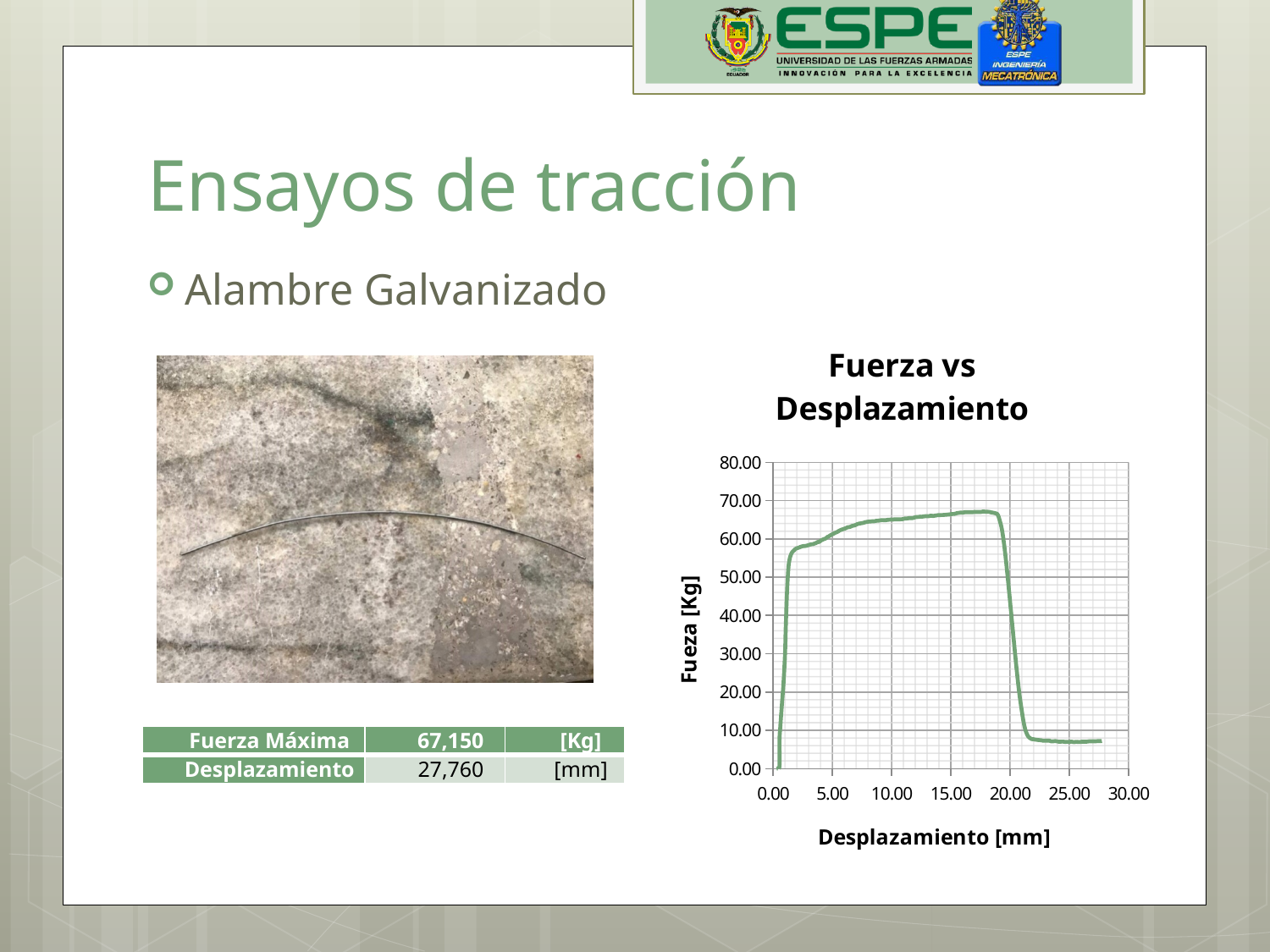
In the Fuerza vs Desplazamiento chart, is the force at a displacement of 10.00 mm greater or less than 60.00? greater In the Fuerza vs Desplazamiento chart, which is larger: the force at 10.00 mm or the force at 25.00 mm? the force at 10.00 mm In the Fuerza vs Desplazamiento chart, does the force rise or fall between displacements of 20.00 mm and 22.00 mm? fall In the Fuerza vs Desplazamiento chart, is the force at a displacement of 25.00 mm greater or less than 10.00? less In the Fuerza vs Desplazamiento chart, is the force at a displacement of 15.00 mm greater or less than 70.00? less What is the label of the x axis of the chart? Desplazamiento [mm] What kind of chart is shown on the slide? line chart How many lines (data series) are plotted in the Fuerza vs Desplazamiento chart? 1 What is the highest value shown on the y axis of the Fuerza vs Desplazamiento chart? 80.00 In the Fuerza vs Desplazamiento chart, does the force rise or fall between displacements of 5.00 mm and 15.00 mm? rise What is the title of the chart on the slide? Fuerza vs Desplazamiento